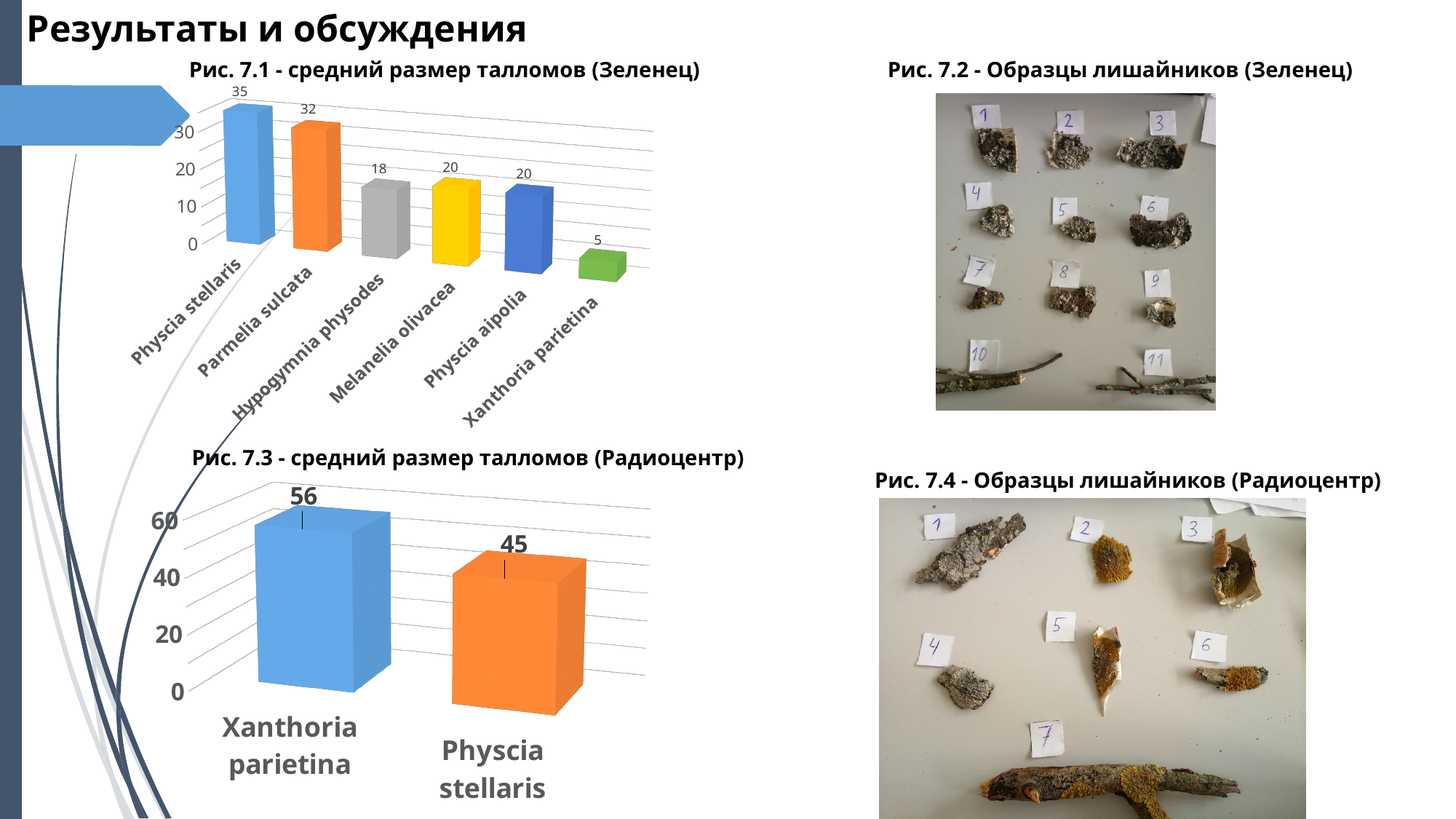
In the chart 'Рис. 7.1 - средний размер талломов (Зеленец)', how many categories are shown? 6 In the chart 'Рис. 7.1 - средний размер талломов (Зеленец)', what is the value for Physcia stellaris? 35 What kind of chart is 'Рис. 7.3 - средний размер талломов (Радиоцентр)'? Bar chart In the chart 'Рис. 7.1 - средний размер талломов (Зеленец)', which category has the highest value? Physcia stellaris In the chart 'Рис. 7.1 - средний размер талломов (Зеленец)', what is the difference between the values for Physcia stellaris and Xanthoria parietina? 30 In the chart 'Рис. 7.3 - средний размер талломов (Радиоцентр)', what is the value for Physcia stellaris? 45 In the chart 'Рис. 7.3 - средний размер талломов (Радиоцентр)', what is the difference between the values for Xanthoria parietina and Physcia stellaris? 11 In the chart 'Рис. 7.1 - средний размер талломов (Зеленец)', which is larger, the value for Parmelia sulcata or Melanelia olivacea? Parmelia sulcata In the chart 'Рис. 7.1 - средний размер талломов (Зеленец)', what is the value for Hypogymnia physodes? 18 In the chart 'Рис. 7.3 - средний размер талломов (Радиоцентр)', what is the value for Xanthoria parietina? 56 In the chart 'Рис. 7.1 - средний размер талломов (Зеленец)', which category has the lowest value? Xanthoria parietina In the chart 'Рис. 7.1 - средний размер талломов (Зеленец)', what is the value for Parmelia sulcata? 32